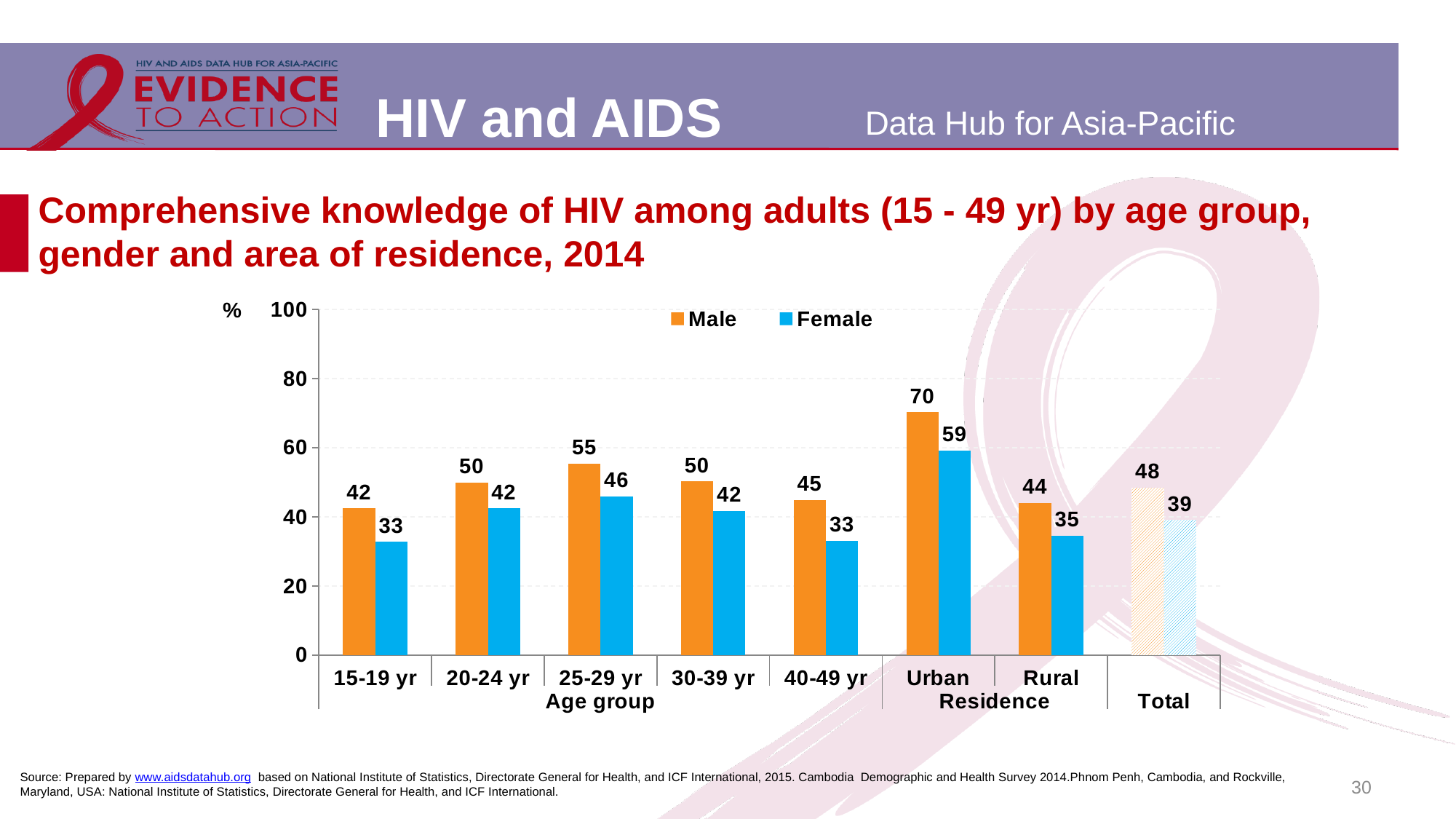
Which category has the highest Male value? Urban Which is larger, the Female value for 25-29 yr or the Female value for 30-39 yr? 25-29 yr What is the Female value for Urban residence? 59 How many series does the legend list? 2 Which category has the lowest Female value? 15-19 yr and 40-49 yr (both 33) What is the difference between the Male and Female values for Rural residence? 9 How many categories are shown on the x axis? 8 Which colour represents the Female series in the chart? Blue What is the Male value for the 25-29 yr age group? 55 Is the Male value for Urban greater or less than 60? greater What is the Female value for the Total category? 39 What kind of chart is shown on the slide? Bar chart